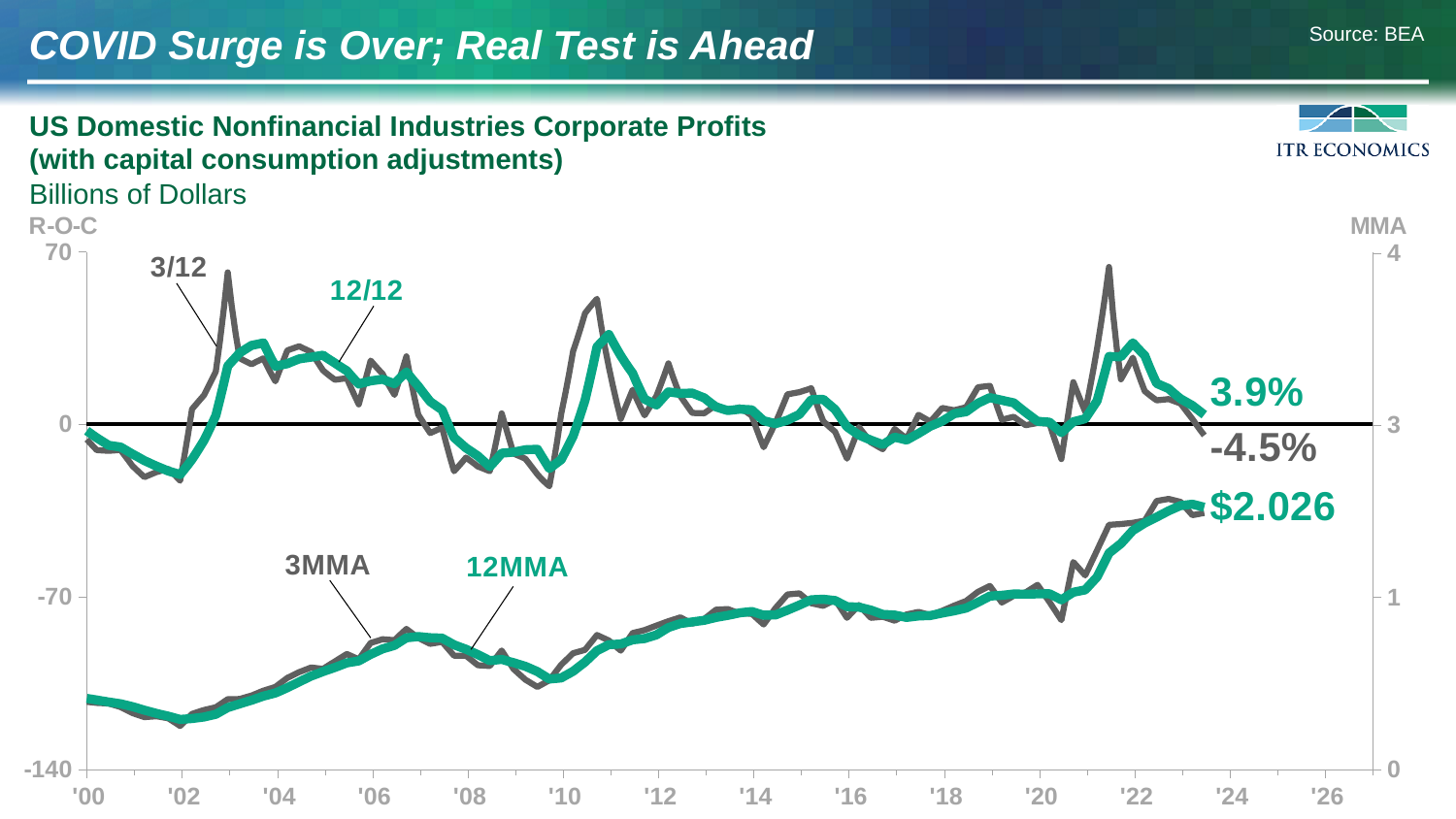
What is the latest value labeled for the 3/12 rate-of-change line? -4.5% How many data series are plotted on the chart? 4 Which is larger at the end of the chart, the 12/12 value or the 3/12 value? 12/12 What type of chart is shown on the slide? line chart What is the difference between the labeled 12/12 value (3.9%) and the labeled 3/12 value (-4.5%)? 8.4 percentage points What is the highest value shown on the left-hand R-O-C axis? 70 What is the overall trend of the 12MMA line from '00 to the end of the chart? rising What is the latest value labeled for the 12MMA line? $2.026 What is the source cited for the chart data? BEA What is the latest value labeled for the 12/12 rate-of-change line? 3.9% What is the unit of measure stated for the chart? Billions of Dollars Is the 12MMA value at the end of the chart greater or less than 1 on the right-hand MMA axis? greater